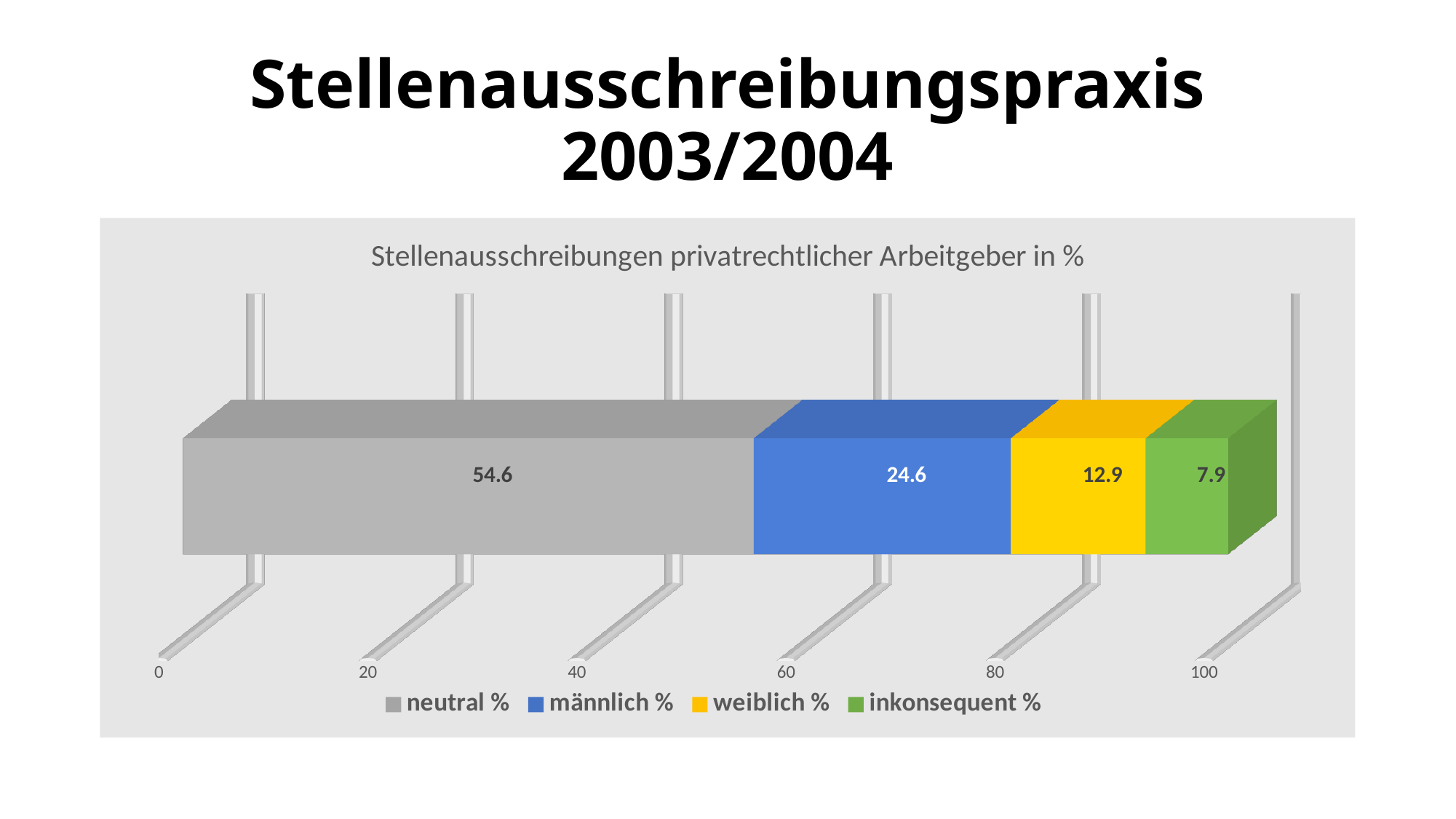
What is the title of the chart? Stellenausschreibungen privatrechtlicher Arbeitgeber in % Which is larger, the value for weiblich % or the value for inkonsequent %? weiblich % What is the value for neutral %? 54.6 What kind of chart is shown? bar chart What is the difference between the values for neutral % and männlich %? 30 How many series does the legend list? 4 What is the value for weiblich %? 12.9 What is the value for inkonsequent %? 7.9 What is the value for männlich %? 24.6 What is the total of the stacked bar? 100 Which series has the highest value? neutral % Which series has the lowest value? inkonsequent %